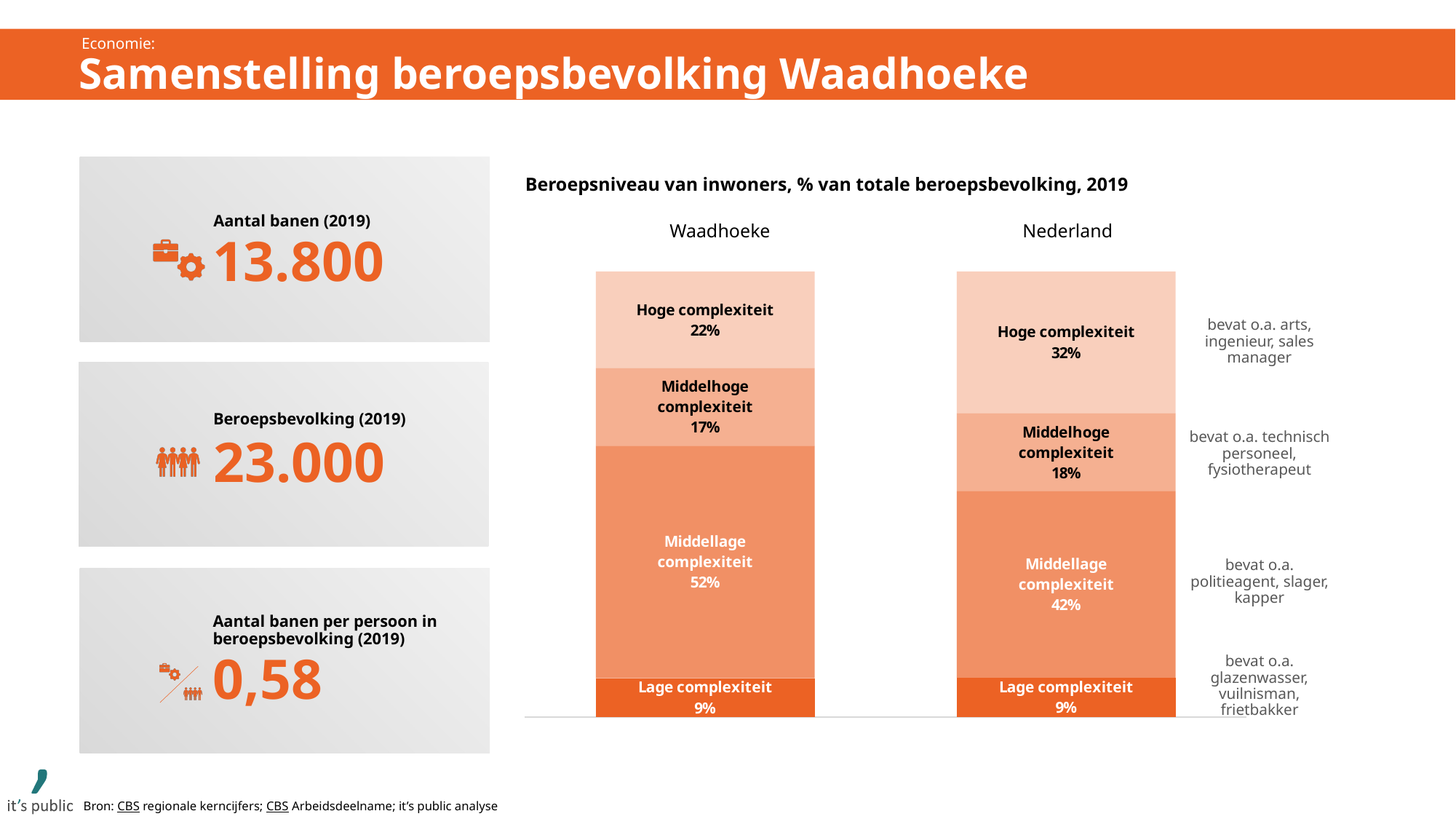
What is the difference between the 'Hoge complexiteit' share in Nederland and in Waadhoeke? 10 percentage points What is the difference between the 'Middellage complexiteit' share in Waadhoeke and in Nederland? 10 percentage points Which category is the smallest in the Nederland bar? Lage complexiteit What type of chart is shown on the slide? Stacked bar chart What is the value for 'Middelhoge complexiteit' in the Nederland bar? 18% How many categories (segments) does each stacked bar contain? 4 Which category is the largest in the Waadhoeke bar? Middellage complexiteit What percentage of the Nederland workforce is in the 'Hoge complexiteit' category? 32% Which has a larger 'Middelhoge complexiteit' share, Waadhoeke or Nederland? Nederland What is the total of the Waadhoeke stacked bar? 100% What percentage of the Waadhoeke workforce is in the 'Middellage complexiteit' category? 52% What is the value for 'Lage complexiteit' in the Waadhoeke bar? 9%